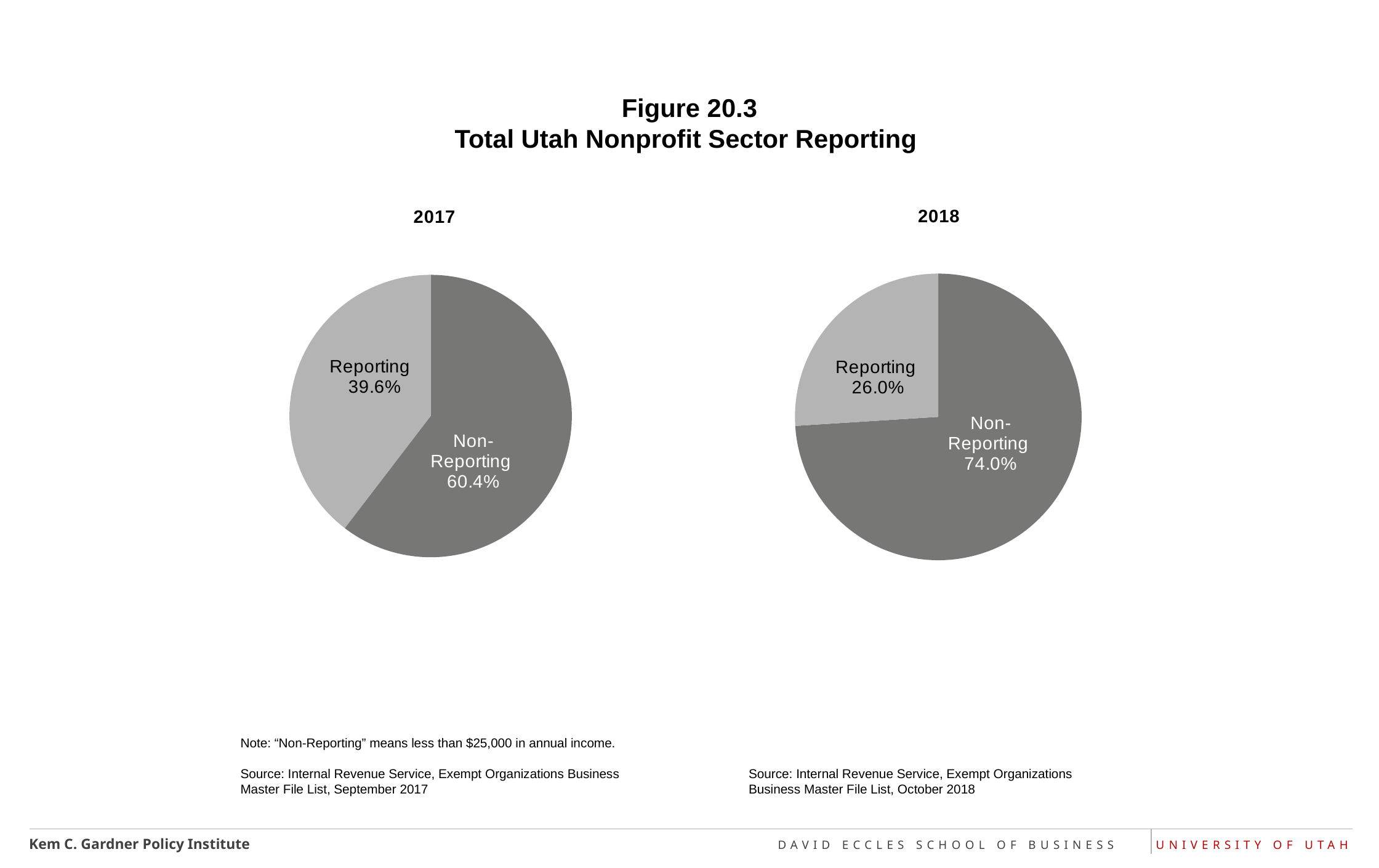
In the 2018 pie chart, which slice is the smallest? Reporting In the 2018 pie chart, what share is labelled for Reporting? 26.0% What is the title of the figure shown on the slide? Figure 20.3 Total Utah Nonprofit Sector Reporting Comparing the two pie charts, is the Reporting share larger in 2017 or in 2018? 2017 In the 2018 pie chart, what share is labelled for Non-Reporting? 74.0% What type of chart is used for the 2018 data? Pie chart In the 2018 pie chart, what is the difference in percentage points between Non-Reporting and Reporting? 48.0 percentage points By how many percentage points did the Reporting share fall from 2017 to 2018? 13.6 percentage points In the 2017 pie chart, what share is labelled for Reporting? 39.6% How many slices does the 2017 pie chart have? 2 In the 2017 pie chart, what share is labelled for Non-Reporting? 60.4% In the 2017 pie chart, which slice is the largest? Non-Reporting